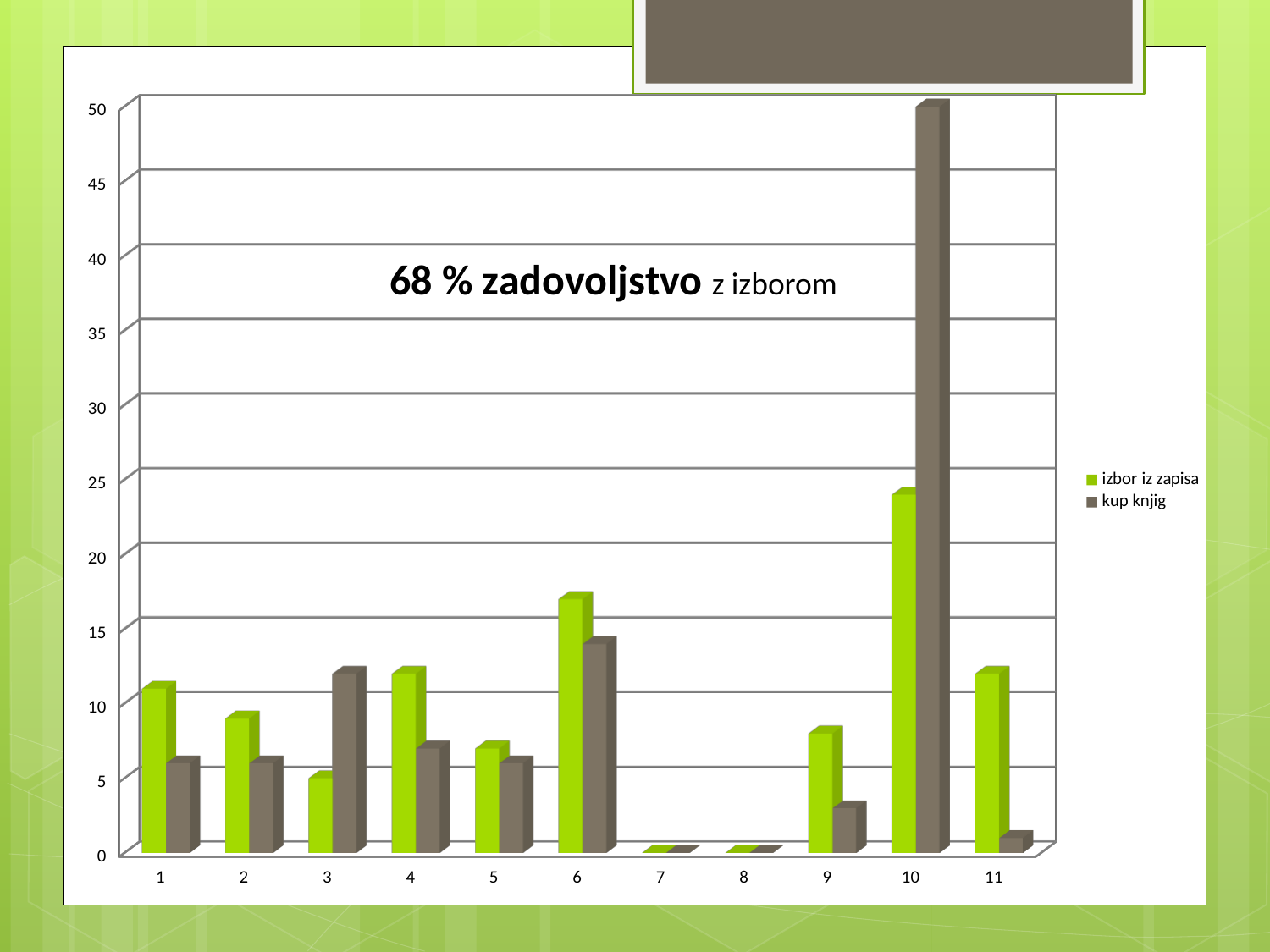
For category 3, which series has the larger value, 'izbor iz zapisa' or 'kup knjig'? kup knjig Is the 'kup knjig' value for category 9 greater or less than 5? less Is the 'izbor iz zapisa' value for category 10 greater or less than 20? greater Is the 'kup knjig' value for category 10 greater or less than 40? greater Which category has the highest value for the 'izbor iz zapisa' series? 10 Which category has the highest value for the 'kup knjig' series? 10 What text is written across the chart area? 68 % zadovoljstvo z izborom For category 10, which series has the larger value, 'izbor iz zapisa' or 'kup knjig'? kup knjig How many categories are shown on the x axis? 11 What kind of chart is shown on the slide? bar chart How many series does the legend list? 2 What are the two series names listed in the legend? izbor iz zapisa, kup knjig